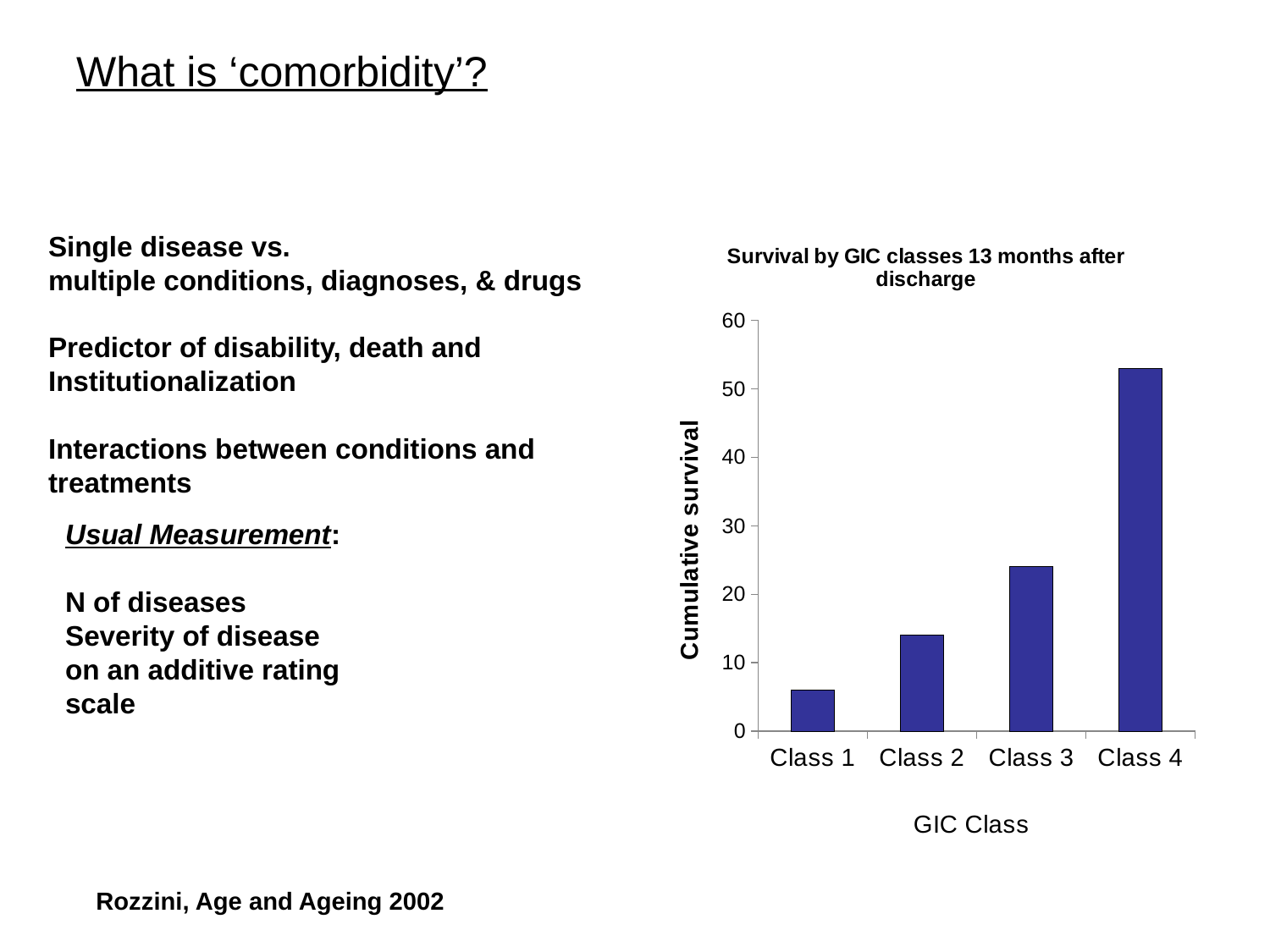
Is the cumulative survival for Class 1 greater or less than 10? less Does cumulative survival rise or fall from Class 1 to Class 4? rise What is the title of the chart? Survival by GIC classes 13 months after discharge Which has a higher cumulative survival, Class 2 or Class 3? Class 3 How many GIC classes are plotted on the chart? 4 Which GIC class has the lowest cumulative survival? Class 1 Is the cumulative survival for Class 3 greater or less than 30? less Is the cumulative survival for Class 2 greater or less than 10? greater What kind of chart is shown on the slide? bar chart Which GIC class has the highest cumulative survival? Class 4 What is the label of the vertical axis of the chart? Cumulative survival